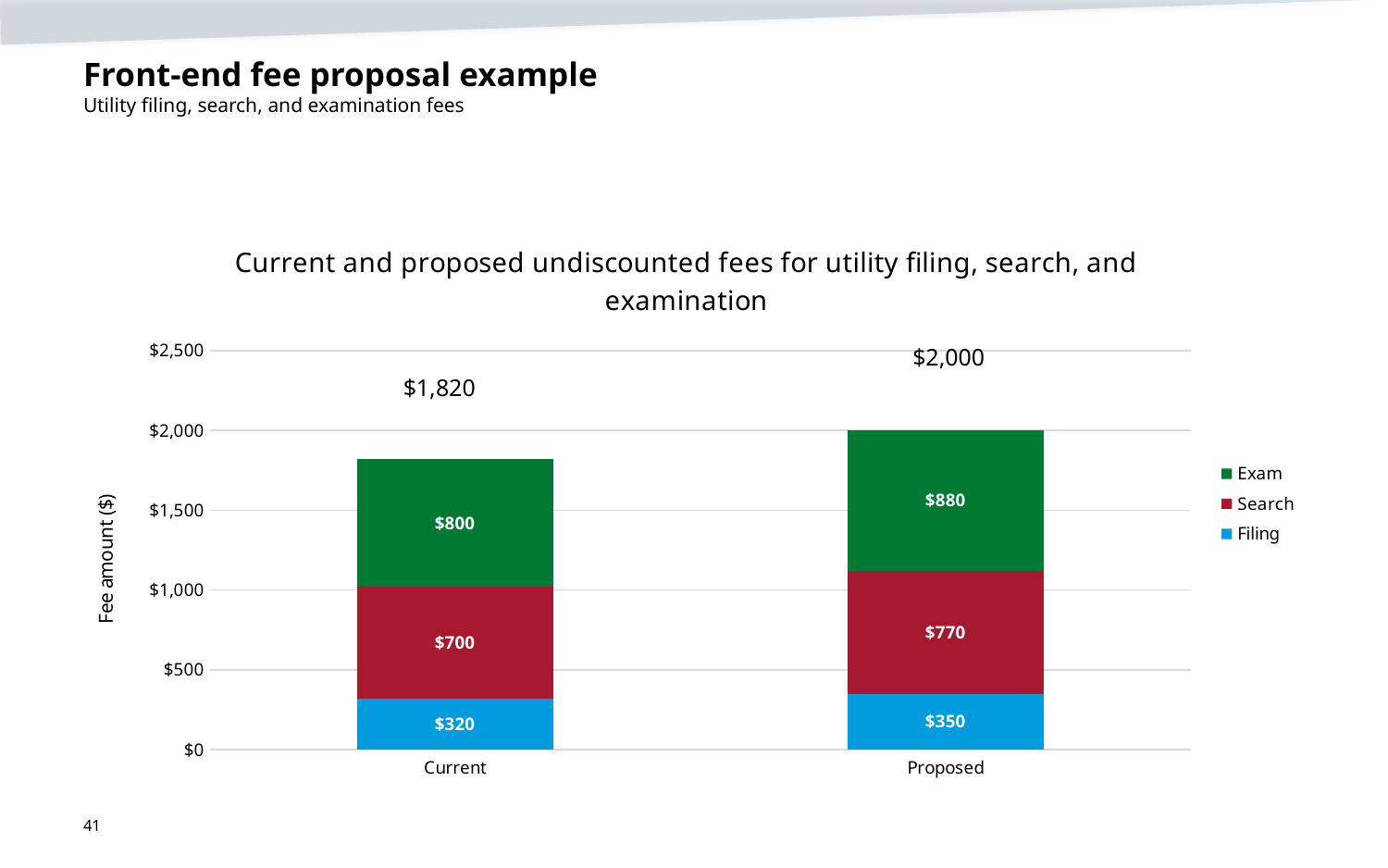
What is the total of the stacked bar for Current? $1,820 What is the Filing fee for the Current category? $320 What is the difference between the Proposed and Current Search fees? $70 What is the Exam fee for the Proposed category? $880 Which category has the higher total fee, Current or Proposed? Proposed What kind of chart is shown on the slide? Stacked bar chart What is the label on the vertical axis? Fee amount ($) What is the Search fee for the Proposed category? $770 What is the difference between the Proposed and Current Exam fees? $80 What is the total of the stacked bar for Proposed? $2,000 Which fee component is the largest in the Current bar? Exam How many series does the legend list? 3